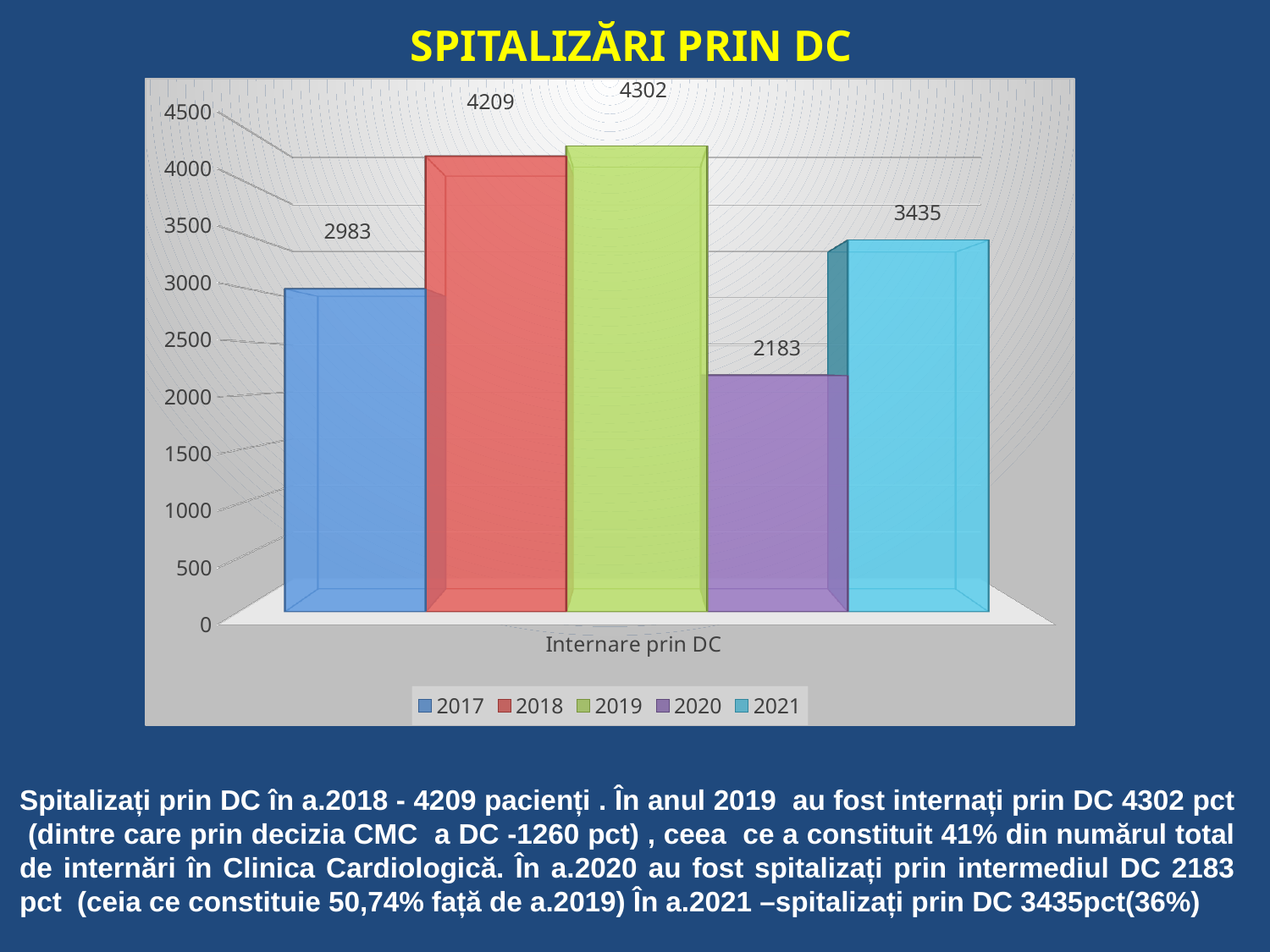
Is the value for 2020 greater or less than 2500? less What is the value for 2021 in the chart? 3435 What is the title of the chart? SPITALIZĂRI PRIN DC What is the value for 2019 in the chart? 4302 What kind of chart is shown on the slide? bar chart What is the difference between the values for 2021 and 2020? 1252 How many series does the legend list? 5 Which is larger, the value for 2017 or the value for 2021? 2021 What is the value for 2017 in the chart? 2983 What is the difference between the values for 2019 and 2018? 93 Which year has the highest value in the chart? 2019 Which year has the lowest value in the chart? 2020